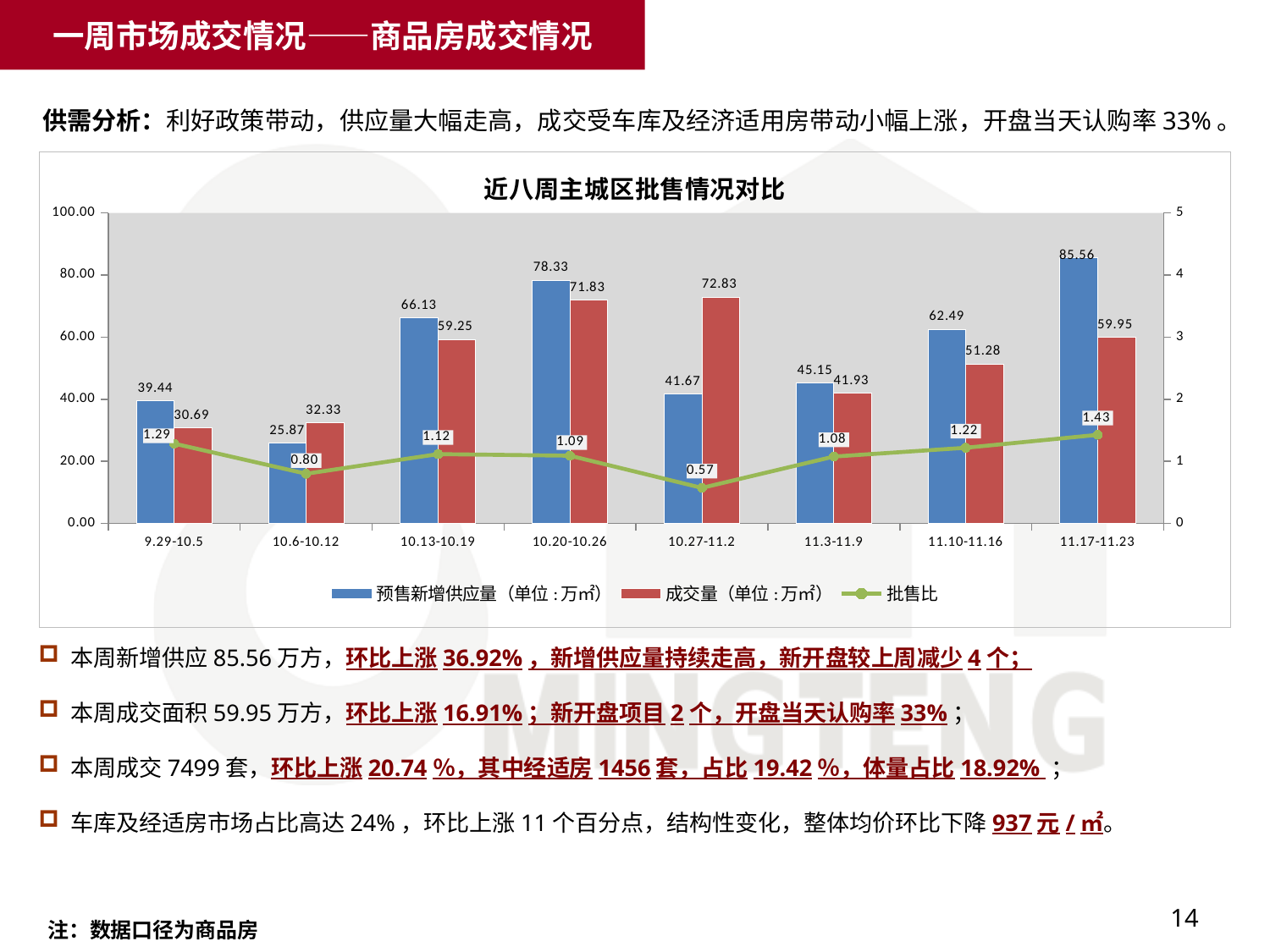
What is the title of the chart? 近八周主城区批售情况对比 How many weeks are shown on the x axis? 8 What is the value of 成交量 for 10.27-11.2? 72.83 Which week has the lowest 批售比? 10.27-11.2 What is the value of 预售新增供应量 for 11.17-11.23? 85.56 Is the 成交量 value for 10.20-10.26 greater or less than 60.00? greater What is the 批售比 value for 10.6-10.12? 0.80 Which week has the highest 预售新增供应量? 11.17-11.23 How many series does the legend list? 3 Which is larger for 10.27-11.2: 预售新增供应量 or 成交量? 成交量 What is the difference between 预售新增供应量 and 成交量 for 11.17-11.23? 25.61 What kind of chart is this? Combined bar and line chart